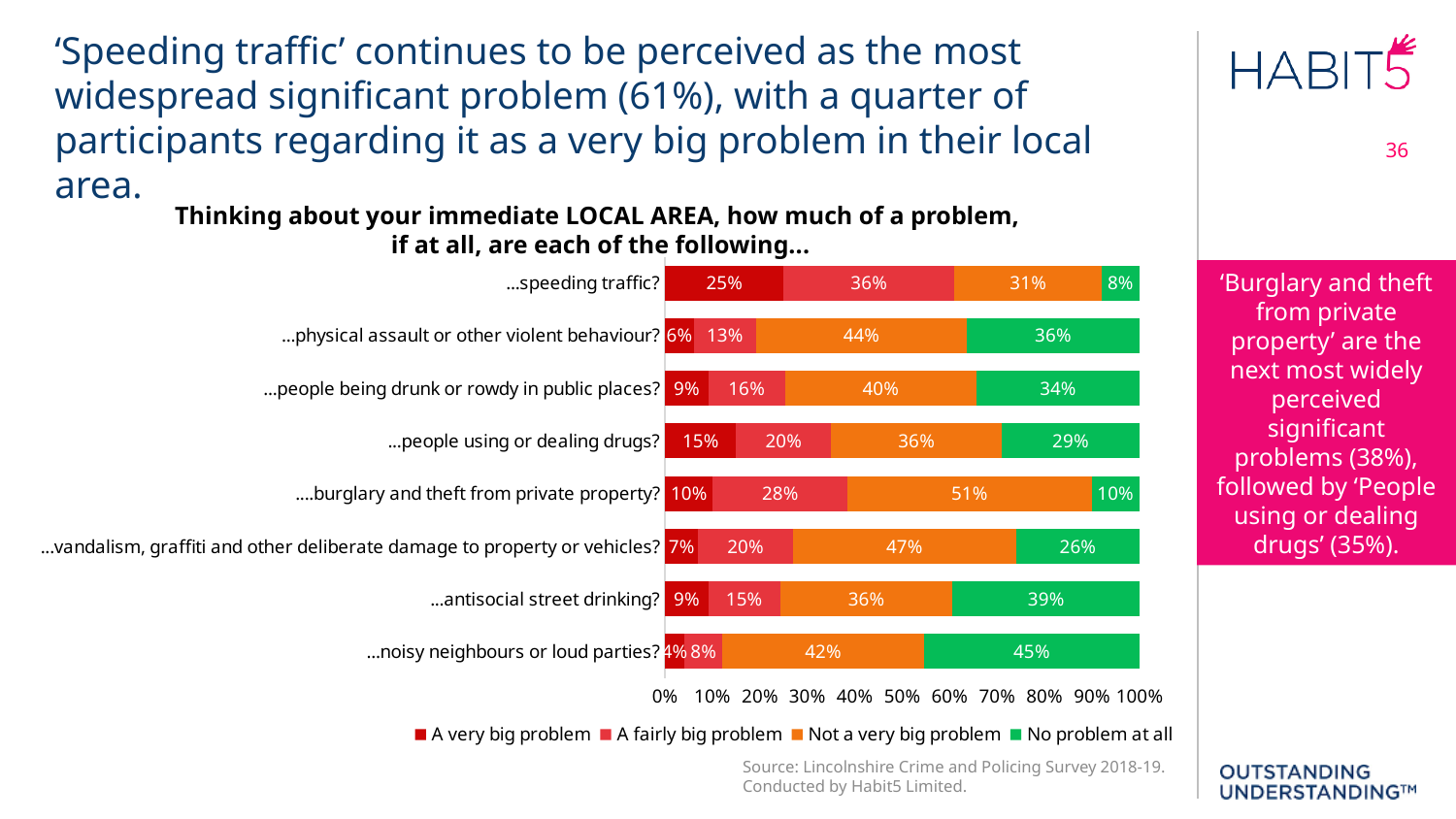
What percentage of participants rated 'speeding traffic' as 'A very big problem'? 25% What is the combined share of 'A very big problem' and 'A fairly big problem' responses for 'speeding traffic'? 61% Which category has the lowest share of 'A very big problem' responses? ...noisy neighbours or loud parties? What is the title of the chart? Thinking about your immediate LOCAL AREA, how much of a problem, if at all, are each of the following... How many percentage points higher is the 'A very big problem' share for 'speeding traffic' than for 'people using or dealing drugs'? 10 percentage points What percentage of participants said 'noisy neighbours or loud parties' is 'No problem at all'? 45% Which has a larger 'No problem at all' share: 'antisocial street drinking' or 'people being drunk or rowdy in public places'? ...antisocial street drinking? Which category has the highest share of 'Not a very big problem' responses? ...burglary and theft from private property? How many series does the chart legend list? 4 What percentage of participants rated 'burglary and theft from private property' as 'A fairly big problem'? 28% How many categories (problem types) are shown in the chart? 8 What kind of chart is shown on the slide? Stacked bar chart